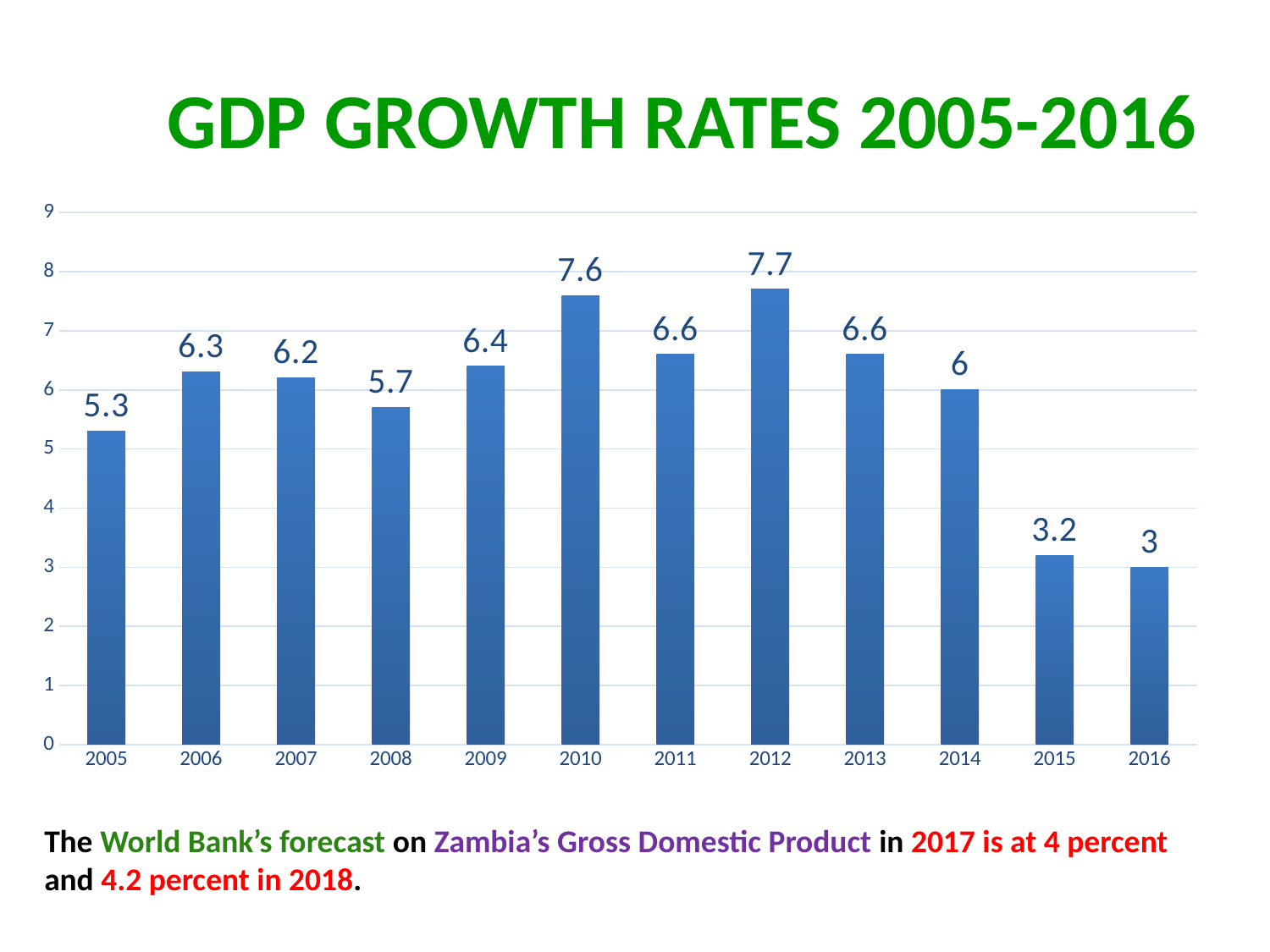
What is the GDP growth rate shown for 2015? 3.2 What is the GDP growth rate shown for 2010? 7.6 What is the difference between the GDP growth rates for 2012 and 2016? 4.7 Which year has the highest GDP growth rate? 2012 How many years are shown on the x axis of the chart? 12 What is the GDP growth rate shown for 2008? 5.7 Which year has the lowest GDP growth rate? 2016 Is the value for 2005 greater or less than 6? less What is the difference between the GDP growth rates for 2014 and 2015? 2.8 Which year has a higher GDP growth rate, 2006 or 2009? 2009 What is the title of the chart? GDP GROWTH RATES 2005-2016 What kind of chart is shown on the slide? bar chart